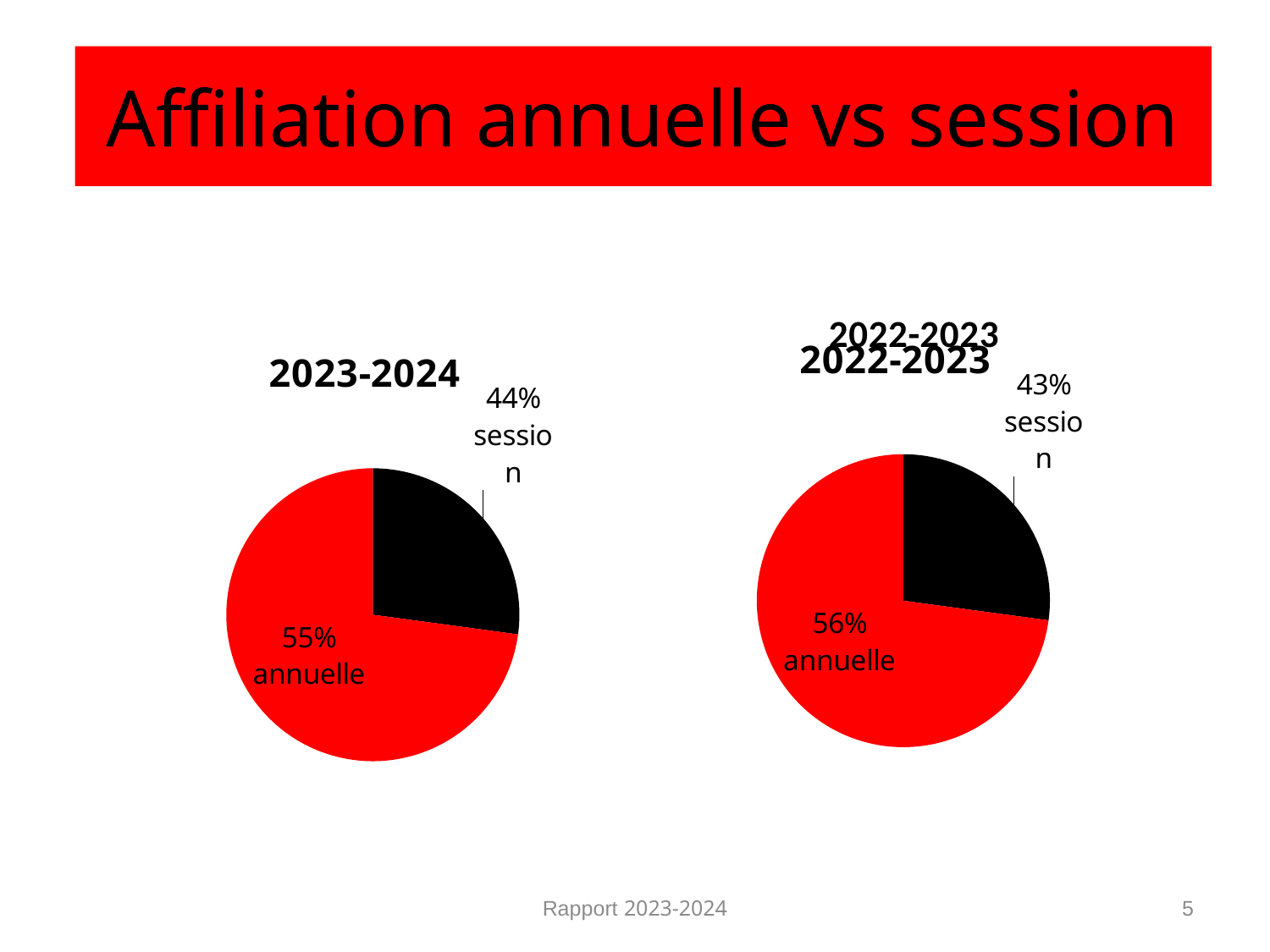
In the 2023-2024 pie chart, what is the difference in percentage points between annuelle and session? 11 In the 2022-2023 pie chart, what is the difference in percentage points between annuelle and session? 13 In the 2022-2023 pie chart, what percentage is labelled for annuelle? 56% Is the annuelle share larger in the 2023-2024 chart or the 2022-2023 chart? 2022-2023 In the 2023-2024 pie chart, what percentage is labelled for session? 44% In the 2023-2024 pie chart, what percentage is labelled for annuelle? 55% In the 2022-2023 pie chart, which slice is the smallest? session In the 2023-2024 pie chart, which slice is the largest? annuelle In the 2022-2023 pie chart, what percentage is labelled for session? 43% What type of chart is used for 2023-2024? pie chart What colour is the annuelle slice in the 2023-2024 pie chart? red How many slices does the 2022-2023 pie chart have? 2